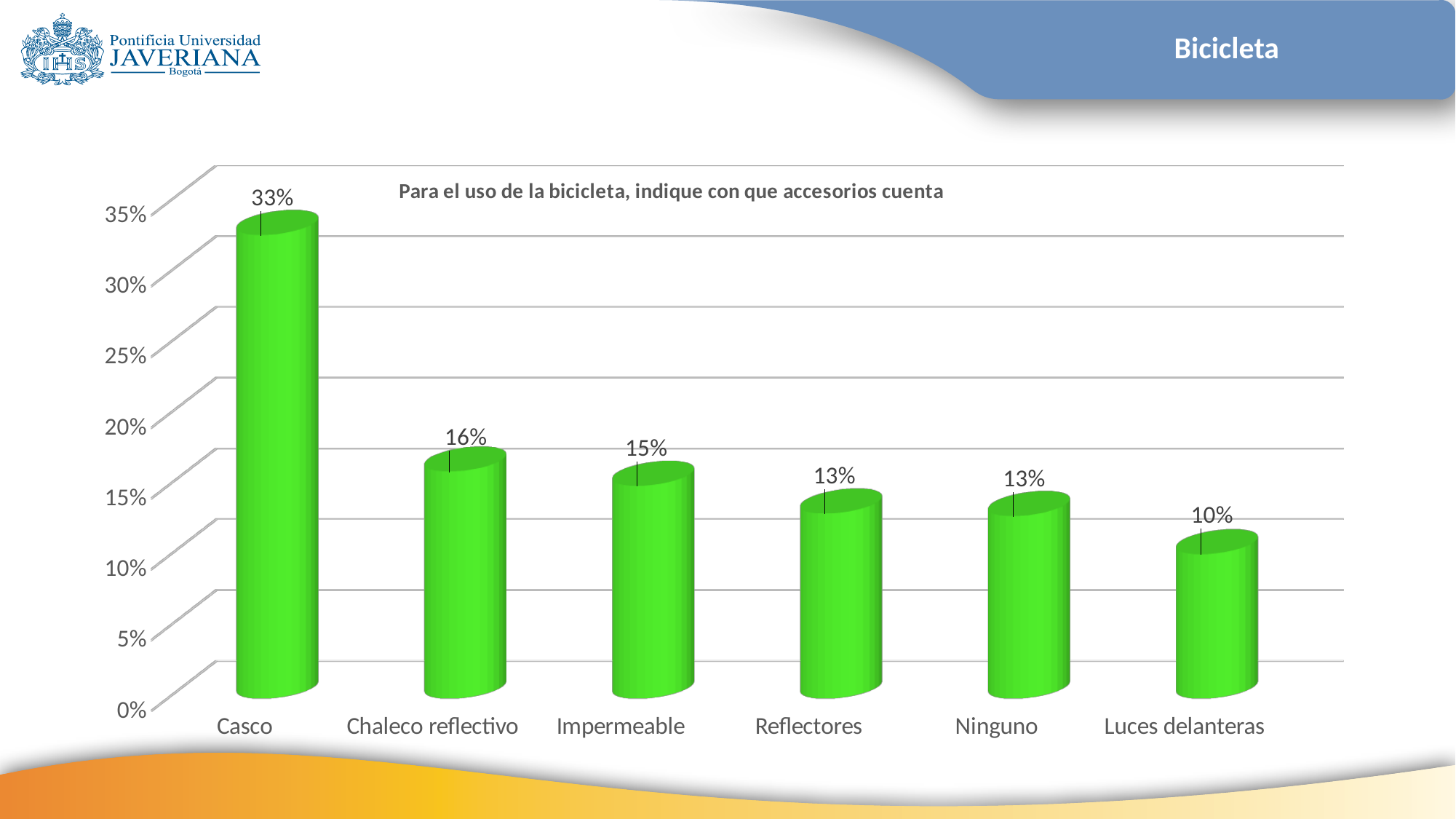
Which category has the lowest value? Luces delanteras Is the value for Casco greater or less than 30%? greater How many categories are shown on the x axis? 6 Which category has the highest value? Casco What kind of chart is shown on the slide? Bar chart What is the value for Chaleco reflectivo? 16% What is the value for Casco? 33% What is the value for Impermeable? 15% Which is larger, the value for Impermeable or the value for Reflectores? Impermeable What is the title of the chart? Para el uso de la bicicleta, indique con que accesorios cuenta What is the value for Luces delanteras? 10% What is the difference between the values for Casco and Chaleco reflectivo? 17%